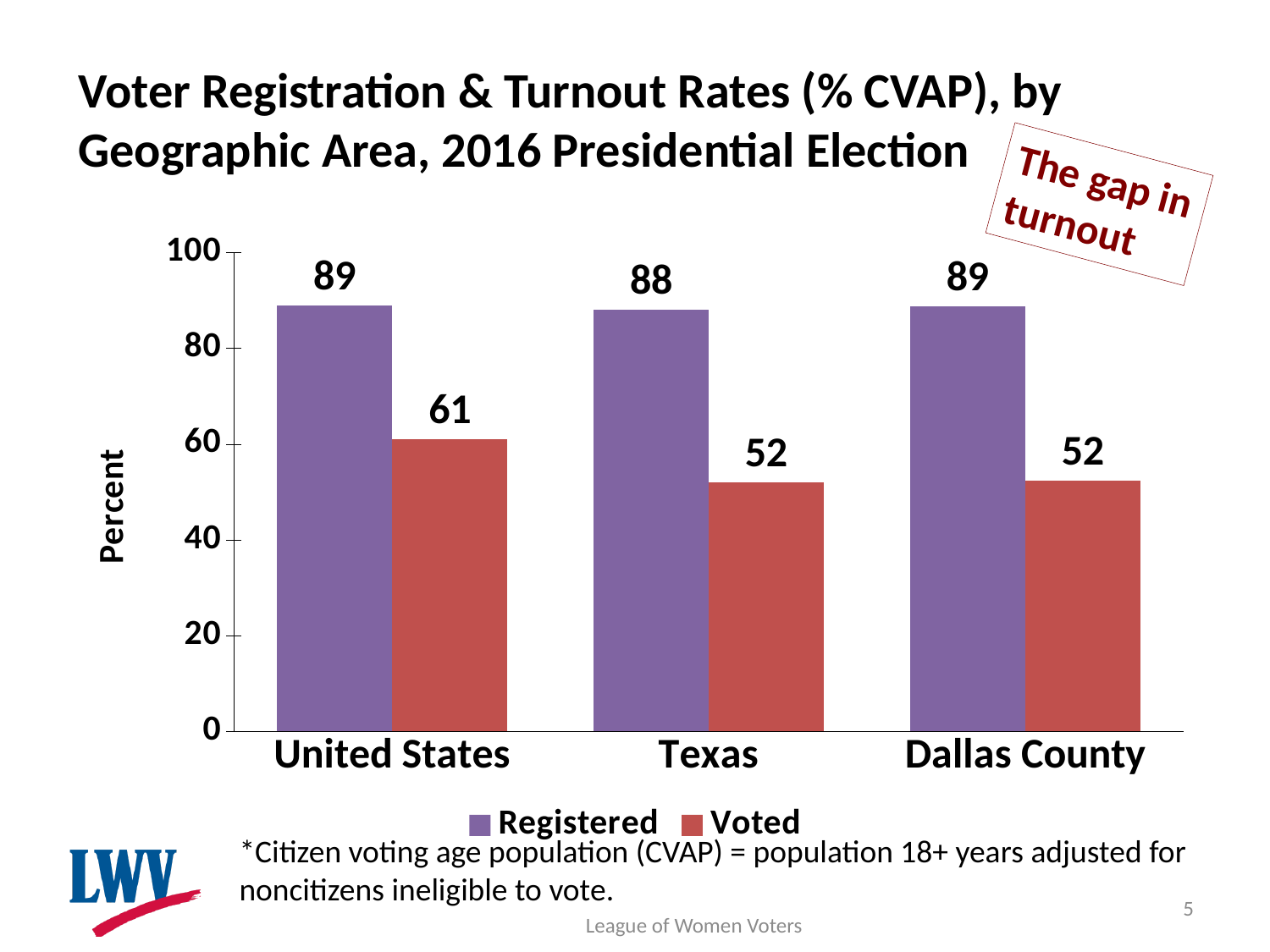
What is the label of the y axis? Percent What kind of chart is shown on the slide? Bar chart How many series does the legend list? 2 What is the Voted value for Dallas County? 52 Which is larger, the Voted value for the United States or the Voted value for Texas? United States How many geographic areas are shown on the x axis? 3 Which geographic area has the highest Voted value? United States What is the difference between the Registered and Voted values for Texas? 36 Which geographic area has the lowest Registered value? Texas What is the difference between the Voted values for the United States and Dallas County? 9 What is the Registered value for Texas? 88 What is the Voted value for the United States? 61